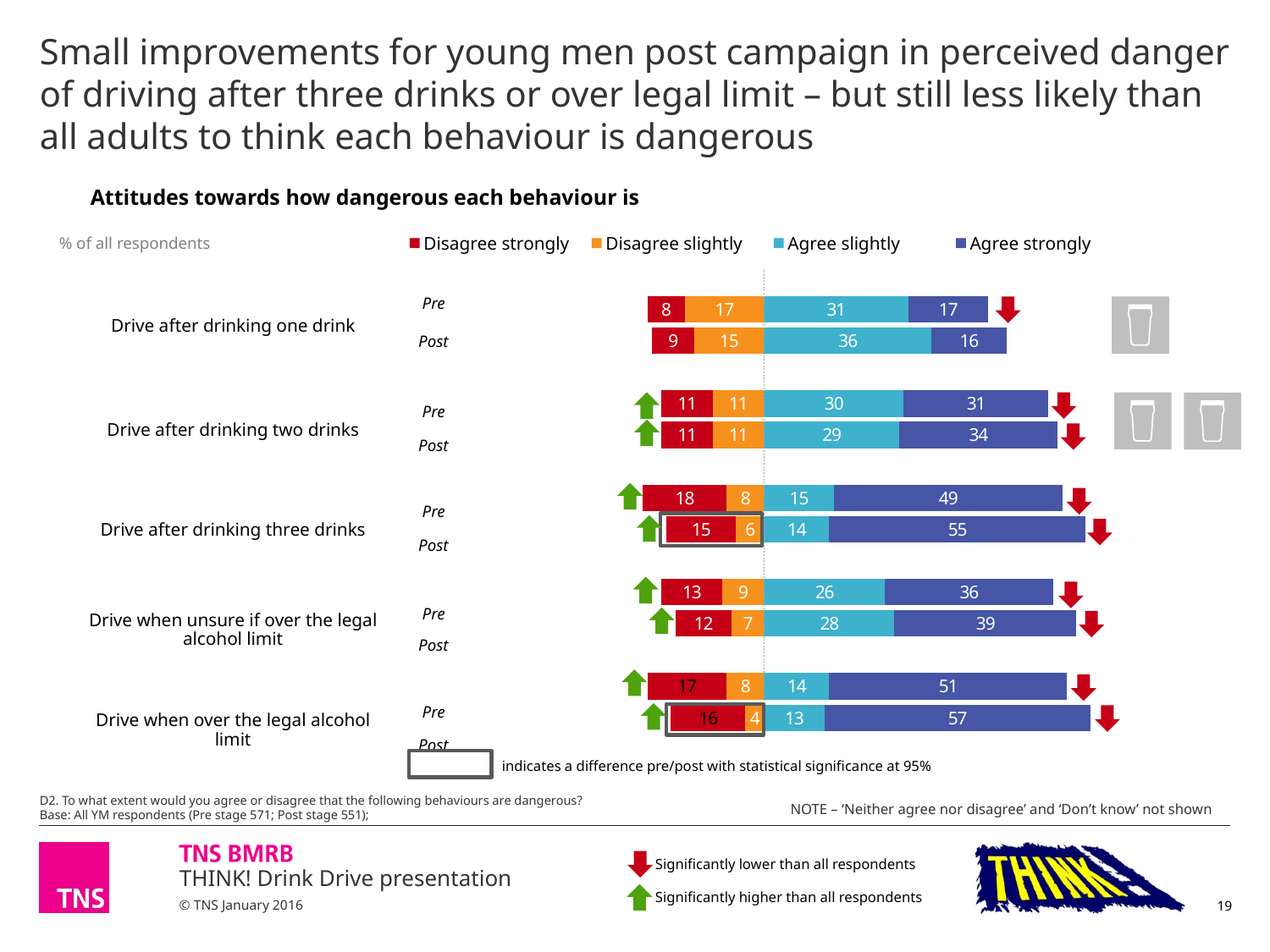
What is the 'Agree strongly' value for 'Drive after drinking three drinks' at the Post stage? 55 What is the total of the four labelled segments for 'Drive after drinking two drinks' at the Post stage? 85 Which bar has the highest 'Agree strongly' value? Drive when over the legal alcohol limit, Post How many behaviours are listed on the chart? 5 How many series does the legend list? 4 What is the 'Agree slightly' value for 'Drive when unsure if over the legal alcohol limit' at the Post stage? 28 Which is larger: the Pre 'Agree slightly' value for 'Drive after drinking one drink' or the Post 'Agree slightly' value for the same behaviour? Post (36) What kind of chart is shown on the slide? Stacked bar chart What is the 'Disagree strongly' value for 'Drive after drinking one drink' at the Pre stage? 8 Which bar has the lowest 'Disagree slightly' value? Drive when over the legal alcohol limit, Post What is the difference between the Post and Pre 'Agree strongly' values for 'Drive when over the legal alcohol limit'? 6 What is the title of the chart? Attitudes towards how dangerous each behaviour is